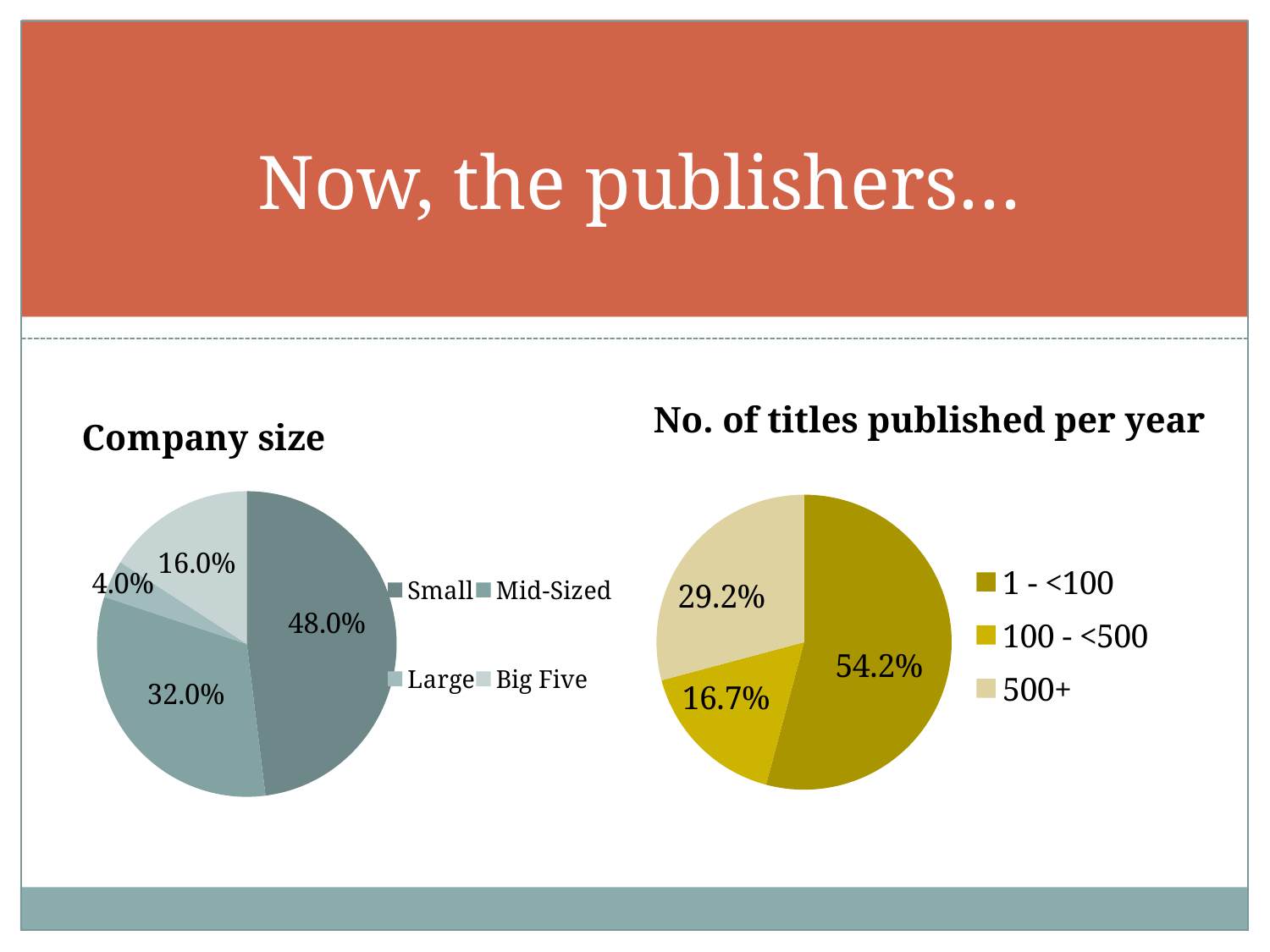
In the 'Company size' chart, what percentage is shown for Big Five? 16.0% In the 'No. of titles published per year' chart, what share of publishers publish 1 - <100 titles? 54.2% What type of chart is the 'Company size' chart? Pie chart In the 'Company size' chart, what share of publishers are Small? 48.0% In the 'No. of titles published per year' chart, which is larger: the share for 500+ or the share for 100 - <500? 500+ In the 'Company size' chart, which category has the smallest slice? Large How many categories does the legend of the 'No. of titles published per year' chart list? 3 In the 'No. of titles published per year' chart, which category has the smallest share? 100 - <500 In the 'Company size' chart, what percentage is shown for Mid-Sized? 32.0% In the 'No. of titles published per year' chart, what percentage is shown for 500+? 29.2% In the 'Company size' chart, which category has the largest slice? Small In the 'Company size' chart, what is the difference between the Small and Mid-Sized shares? 16.0%